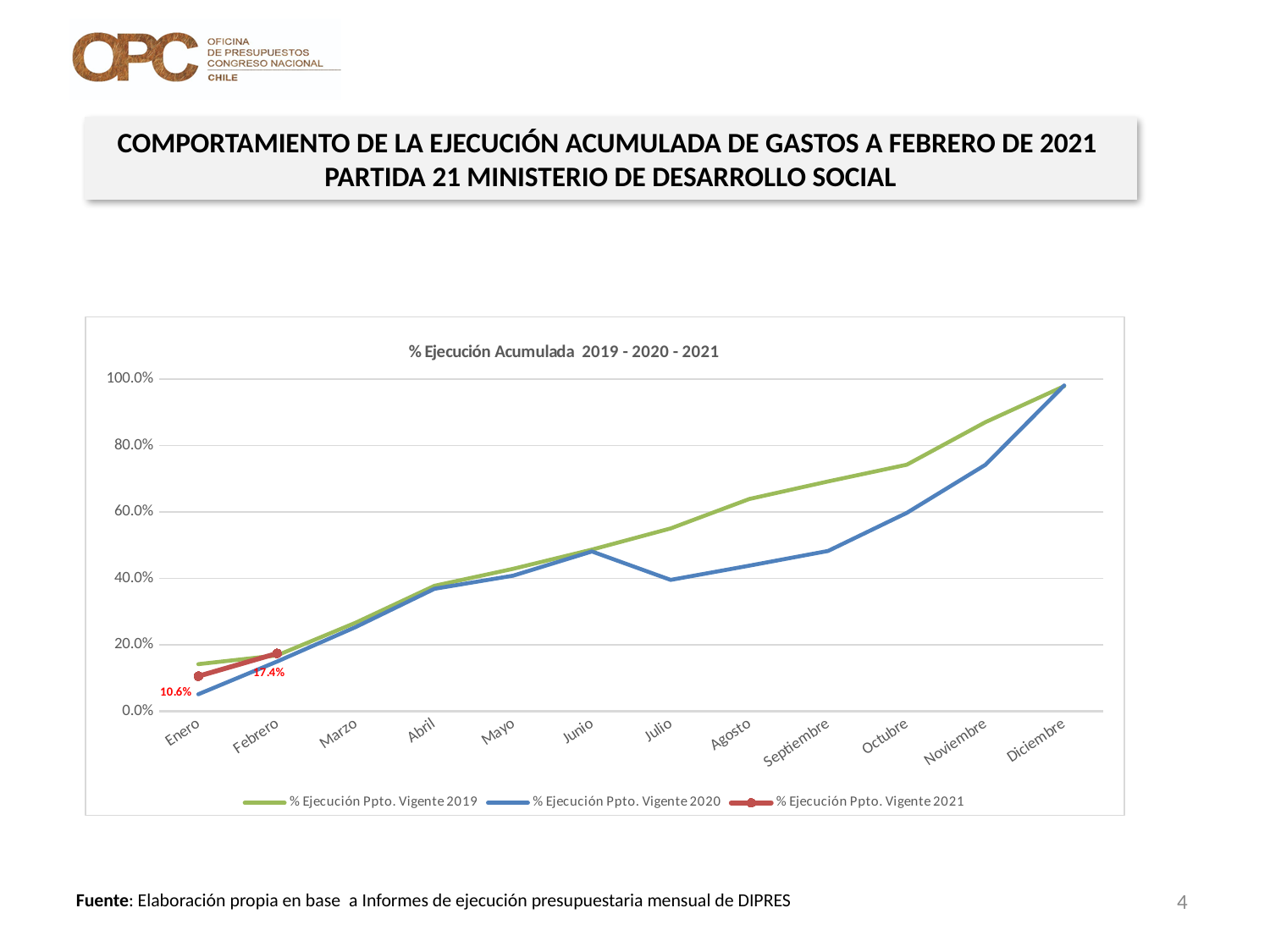
What is the value of % Ejecución Ppto. Vigente 2021 for Febrero? 17.4% Is the value for % Ejecución Ppto. Vigente 2020 in Diciembre greater or less than 80.0%? greater What kind of chart is shown on the slide? Line chart What colour is the line for % Ejecución Ppto. Vigente 2021? Red How many series does the legend list? 3 Is the value for % Ejecución Ppto. Vigente 2020 in Octubre greater or less than 80.0%? less What is the value of % Ejecución Ppto. Vigente 2021 for Enero? 10.6% What is the title of the chart? % Ejecución Acumulada 2019 - 2020 - 2021 Does the % Ejecución Ppto. Vigente 2019 line rise or fall from Enero to Diciembre? Rise How many months are shown on the x axis? 12 In Julio, which series has the higher value: % Ejecución Ppto. Vigente 2019 or % Ejecución Ppto. Vigente 2020? % Ejecución Ppto. Vigente 2019 By how much did % Ejecución Ppto. Vigente 2021 increase from Enero to Febrero? 6.8%